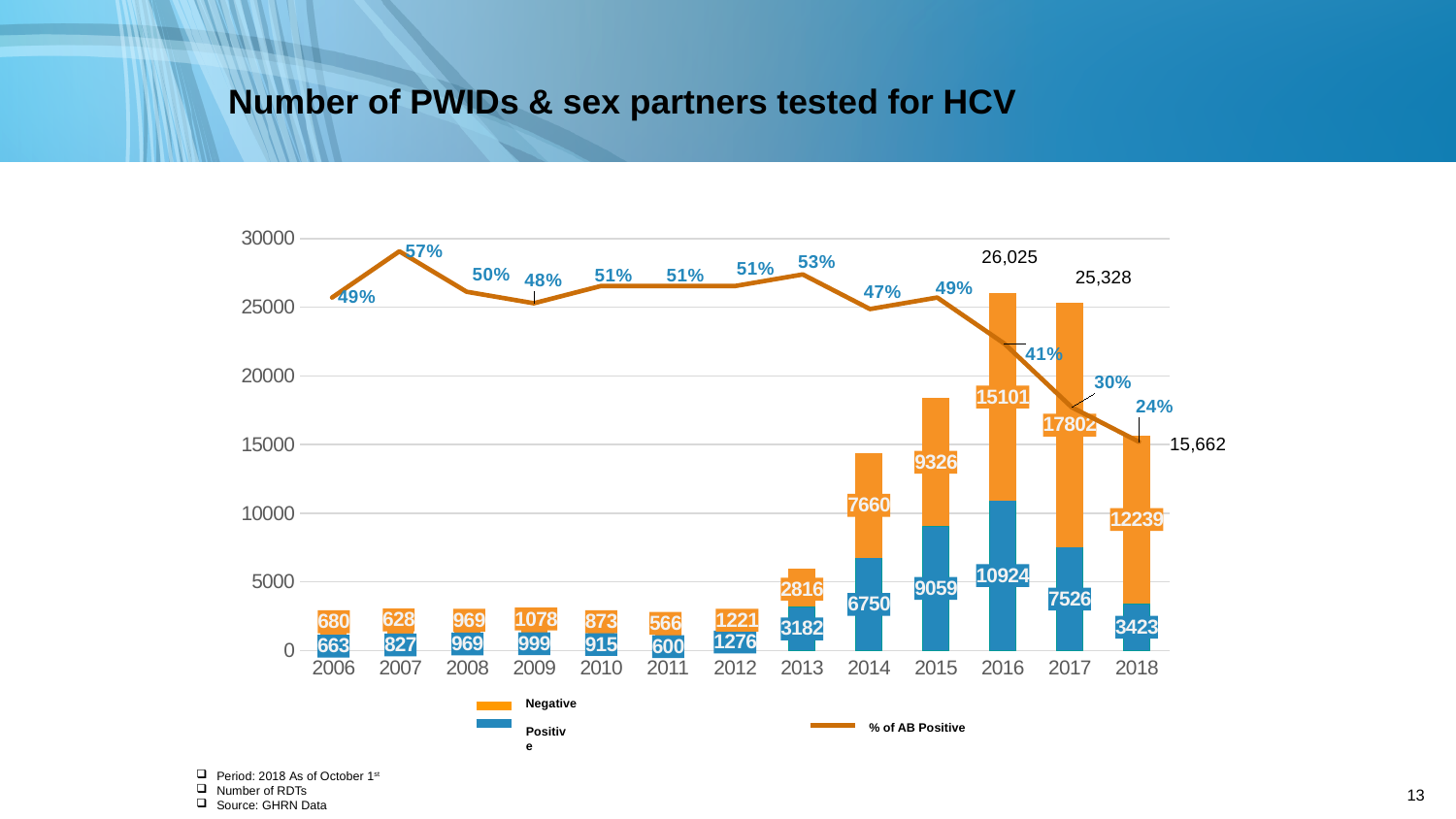
Does the % of AB Positive rise or fall from 2015 to 2018? fall In 2014, which is larger, the Negative value or the Positive value? Negative Which year has the lowest % of AB Positive? 2018 What is the difference between the Negative and Positive values in 2017? 10276 What is the Negative value for 2016? 15101 How many years are shown on the x axis? 13 What is the % of AB Positive for 2007? 57% Which year has the highest Negative value? 2017 Which year has the highest % of AB Positive? 2007 What is the Positive value for 2018? 3423 How many series does the legend list? 3 What is the total of the stacked bar for 2016? 26,025